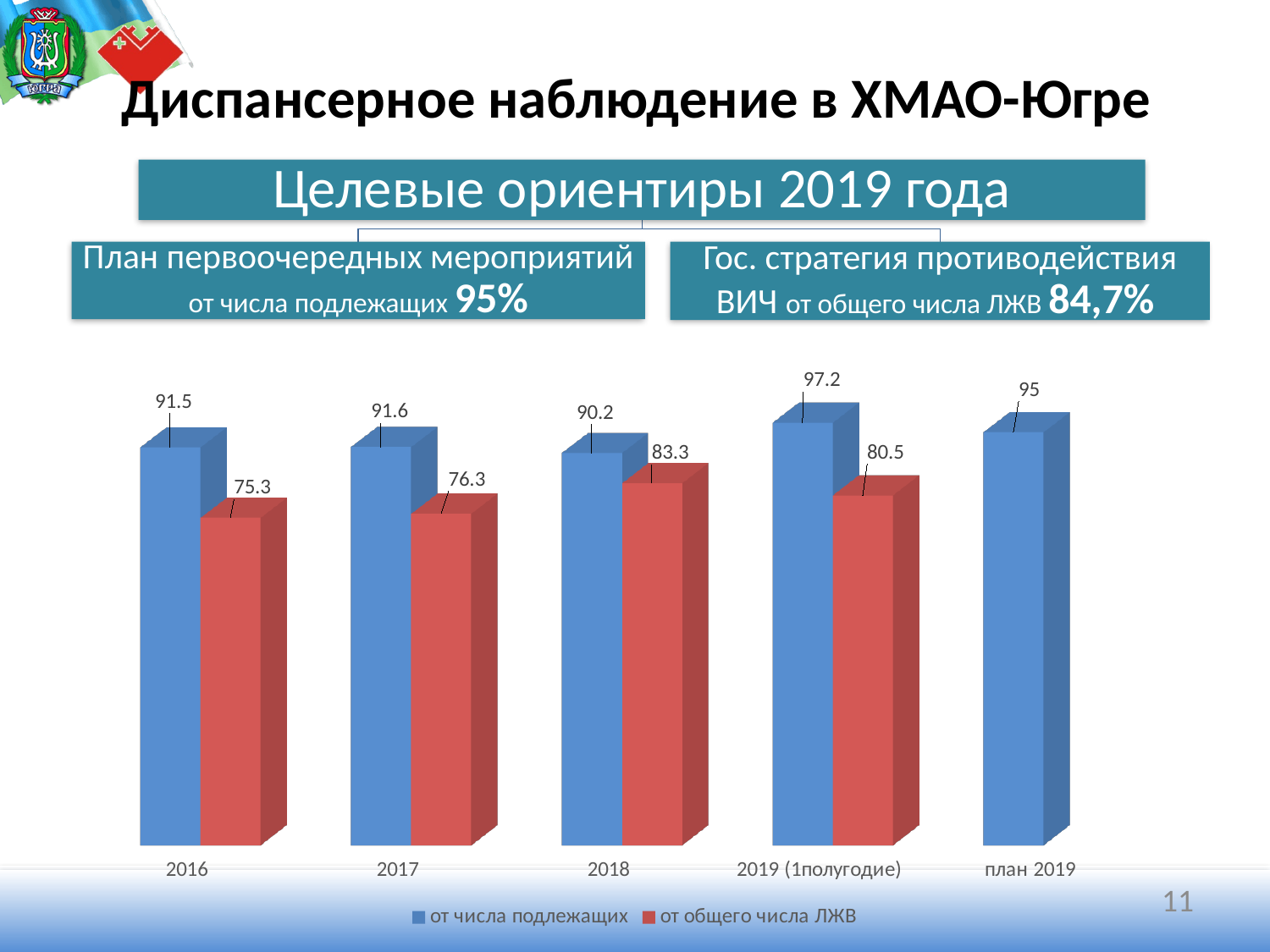
Does the value for "от общего числа ЛЖВ" rise or fall from 2016 to 2018? rise How many categories are shown on the x axis? 5 Which is larger: "от общего числа ЛЖВ" in 2018 or in 2019 (1полугодие)? 2018 What is the value for "от общего числа ЛЖВ" in 2018? 83.3 What is the value for "от числа подлежащих" for "план 2019"? 95 What is the difference between "от числа подлежащих" and "от общего числа ЛЖВ" in 2017? 15.3 Which category has the highest value for "от числа подлежащих"? 2019 (1полугодие) What kind of chart is shown on the slide? bar chart How many series does the legend list? 2 Which category has the lowest value for "от общего числа ЛЖВ"? 2016 What is the value for "от числа подлежащих" in 2016? 91.5 What is the value for "от общего числа ЛЖВ" in 2019 (1полугодие)? 80.5